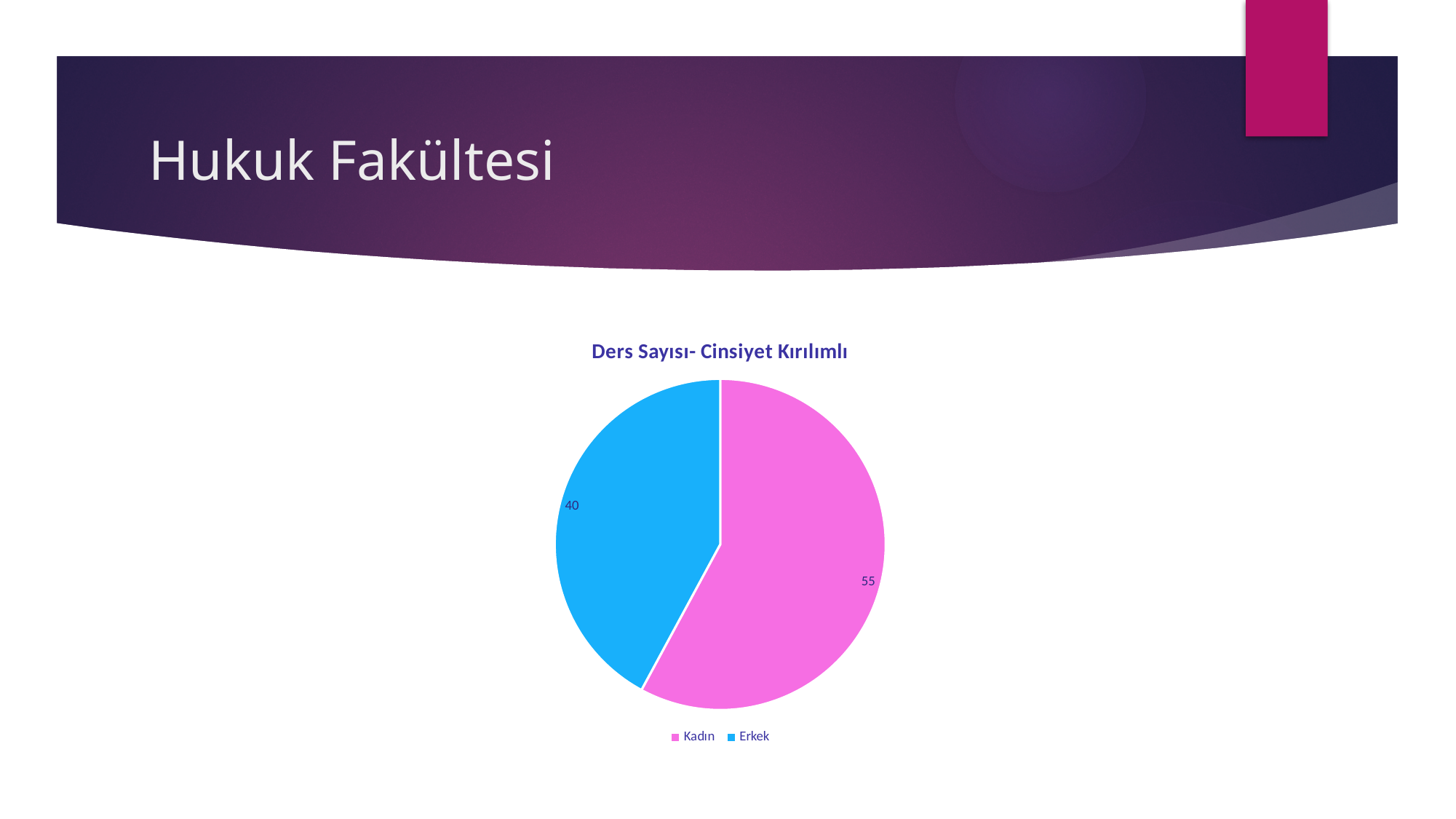
Which category has the smallest slice in the pie chart? Erkek What kind of chart is shown on the slide? Pie chart Which is larger, the value for Kadın or the value for Erkek? Kadın What is the total of all slices in the pie chart? 95 What is the value for Kadın in the pie chart? 55 Which category has the largest slice in the pie chart? Kadın How many slices does the pie chart have? 2 What is the value for Erkek in the pie chart? 40 What colour is the Erkek slice in the pie chart? Blue What is the difference between the Kadın and Erkek values? 15 What is the title of the chart? Ders Sayısı- Cinsiyet Kırılımlı How many entries does the legend list? 2